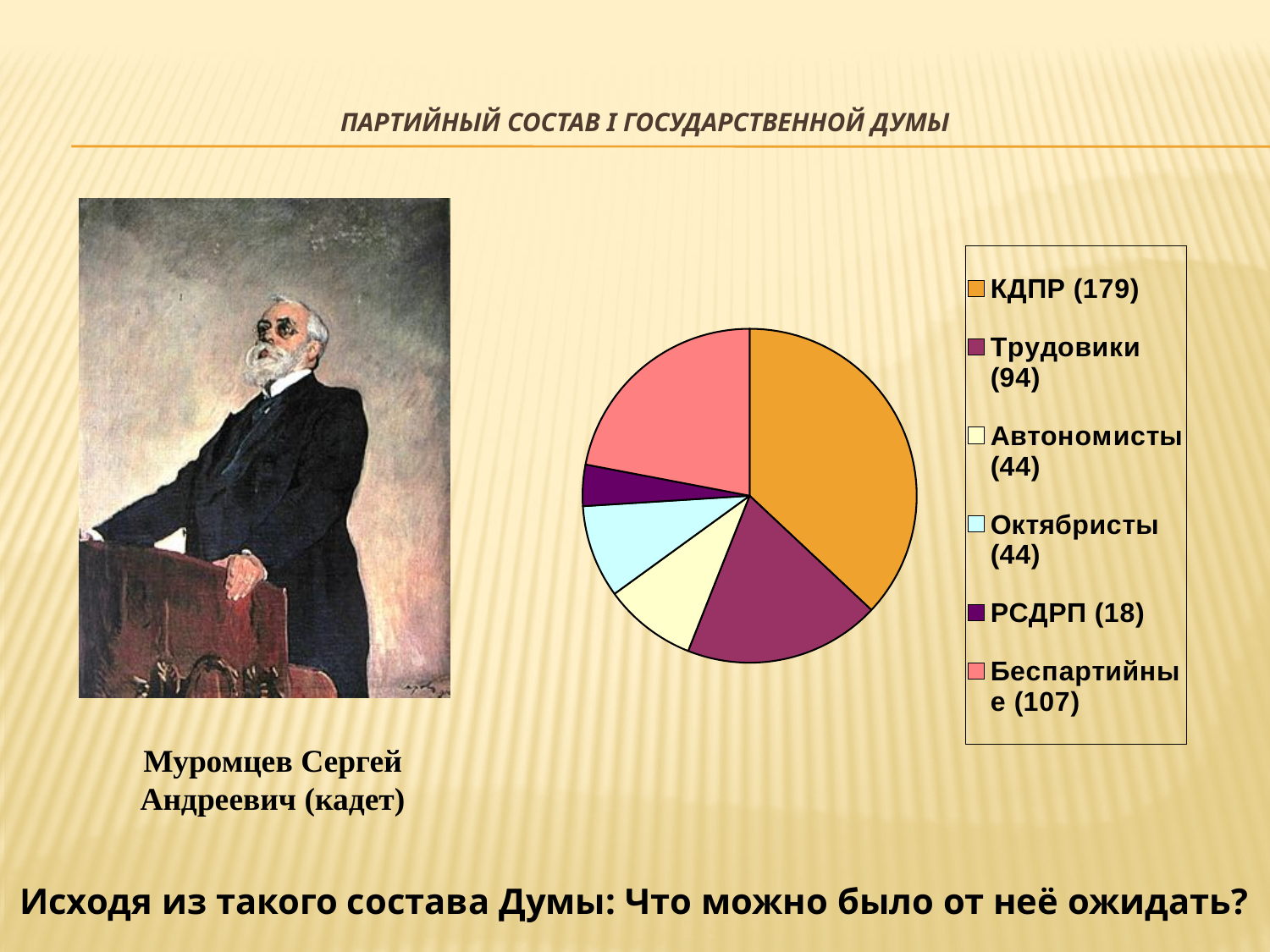
What value is shown for РСДРП? 18 How many seats does the legend give for КДПР? 179 What value is shown for Трудовики in the legend? 94 Which party has the largest slice of the pie? КДПР What is the difference between the values for КДПР and Беспартийные? 72 Which is larger, the value for Трудовики or for Беспартийные? Беспартийные What value is shown for Беспартийные? 107 What kind of chart is shown on the slide? pie chart What is the total of all the values listed in the legend? 486 What colour is the КДПР slice of the pie? orange Which group has the smallest slice of the pie? РСДРП How many categories does the pie chart have? 6